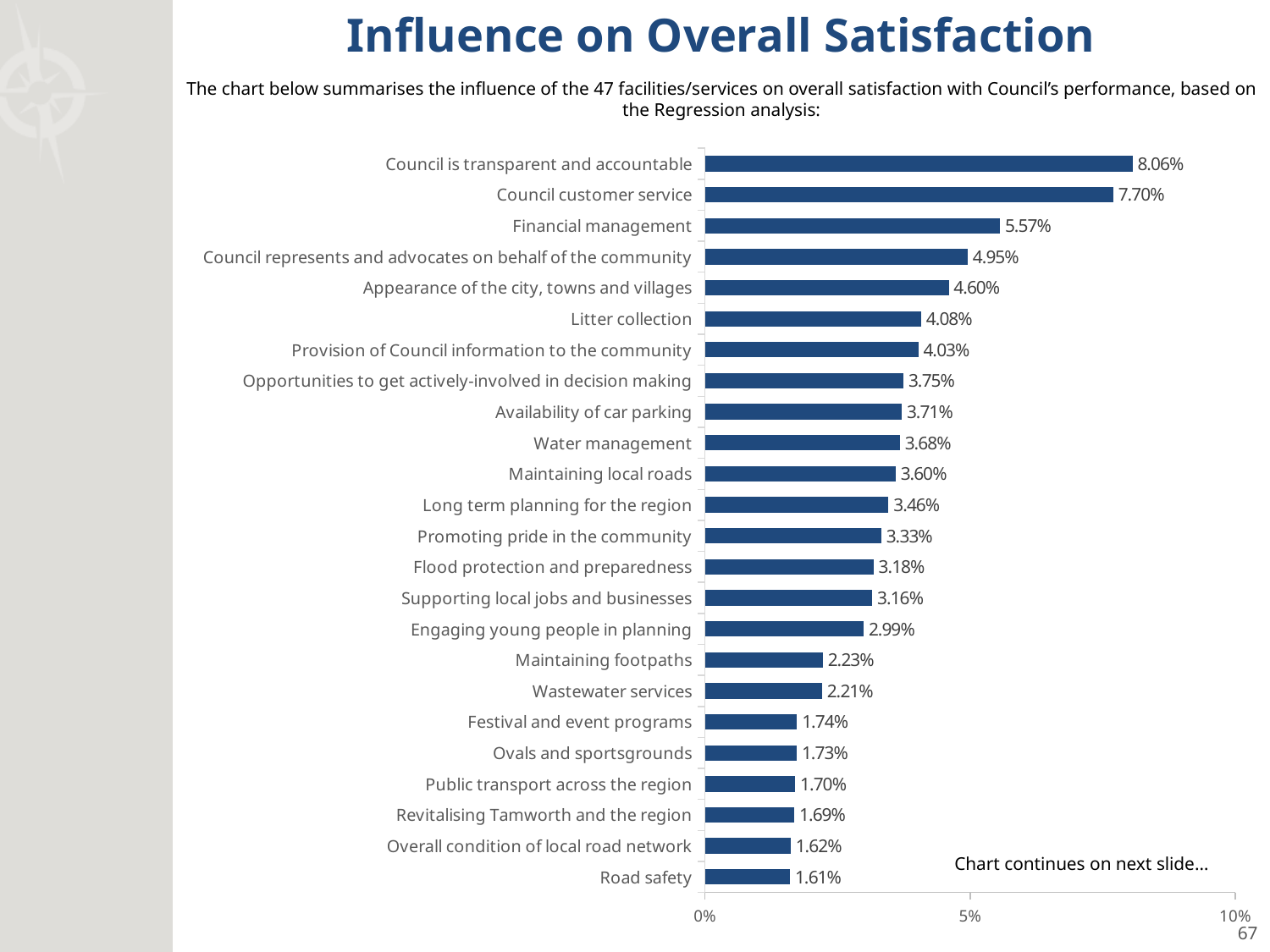
How many categories are shown in the chart? 24 Which category has the lowest value? Road safety Is the value for Council customer service greater or less than 5%? greater What kind of chart is shown on the slide? Bar chart Which category has the highest value? Council is transparent and accountable Which is larger, Water management or Engaging young people in planning? Water management What is the value for Council is transparent and accountable? 8.06% What is the difference between Council customer service and Financial management? 2.13% What is the value for Maintaining footpaths? 2.23% What is the value for Road safety? 1.61% What is the value for Litter collection? 4.08% What is the title of the slide? Influence on Overall Satisfaction